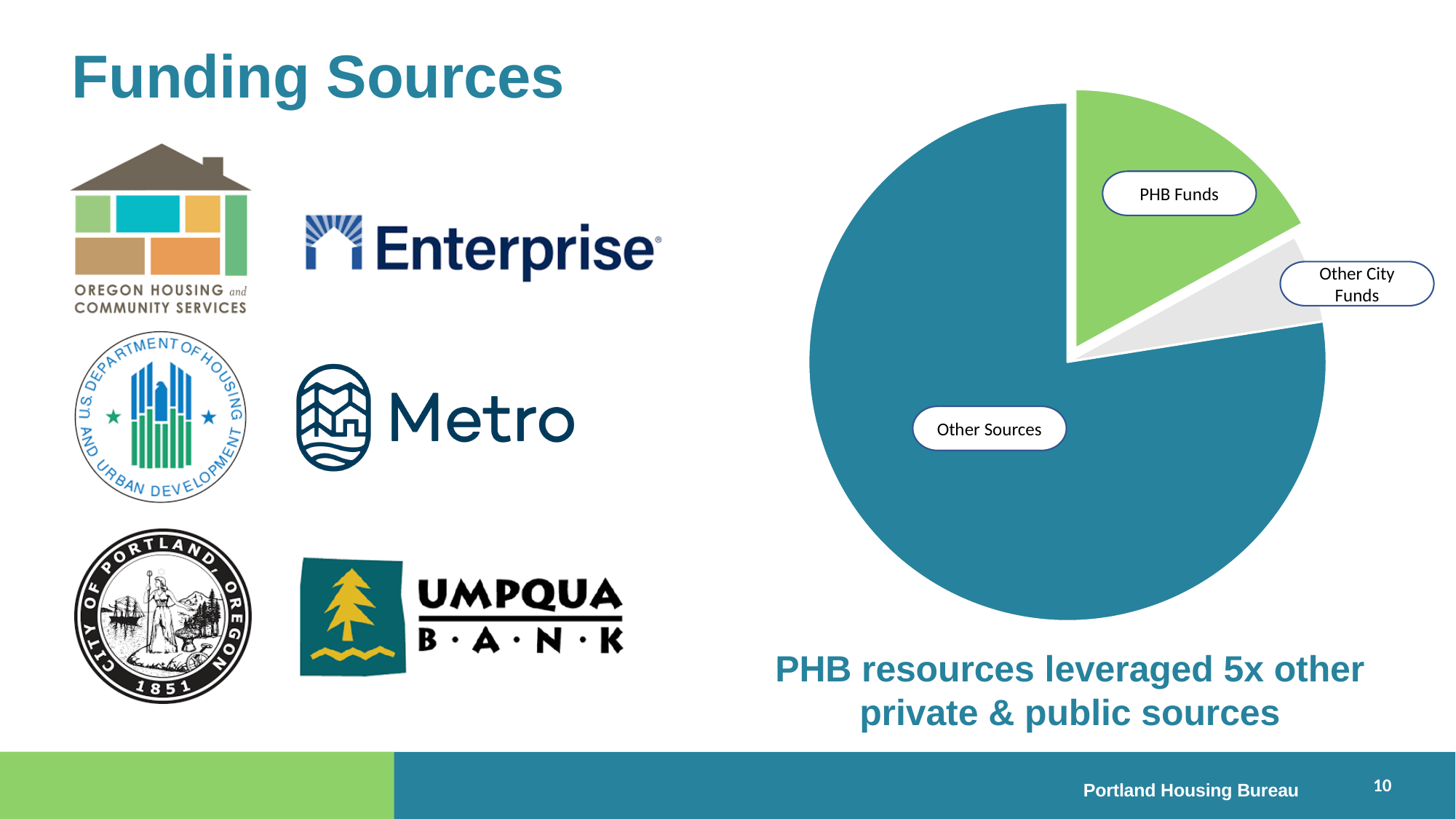
Which slice of the pie chart is the largest? Other Sources What kind of chart is shown on the slide? pie chart Which is larger in the pie chart, Other Sources or Other City Funds? Other Sources What colour is the PHB Funds slice of the pie chart? green Which slice of the pie chart is the smallest? Other City Funds What is the title of the slide containing the pie chart? Funding Sources How many slices does the pie chart have? 3 Which is larger in the pie chart, PHB Funds or Other City Funds? PHB Funds Which is larger in the pie chart, Other Sources or PHB Funds? Other Sources